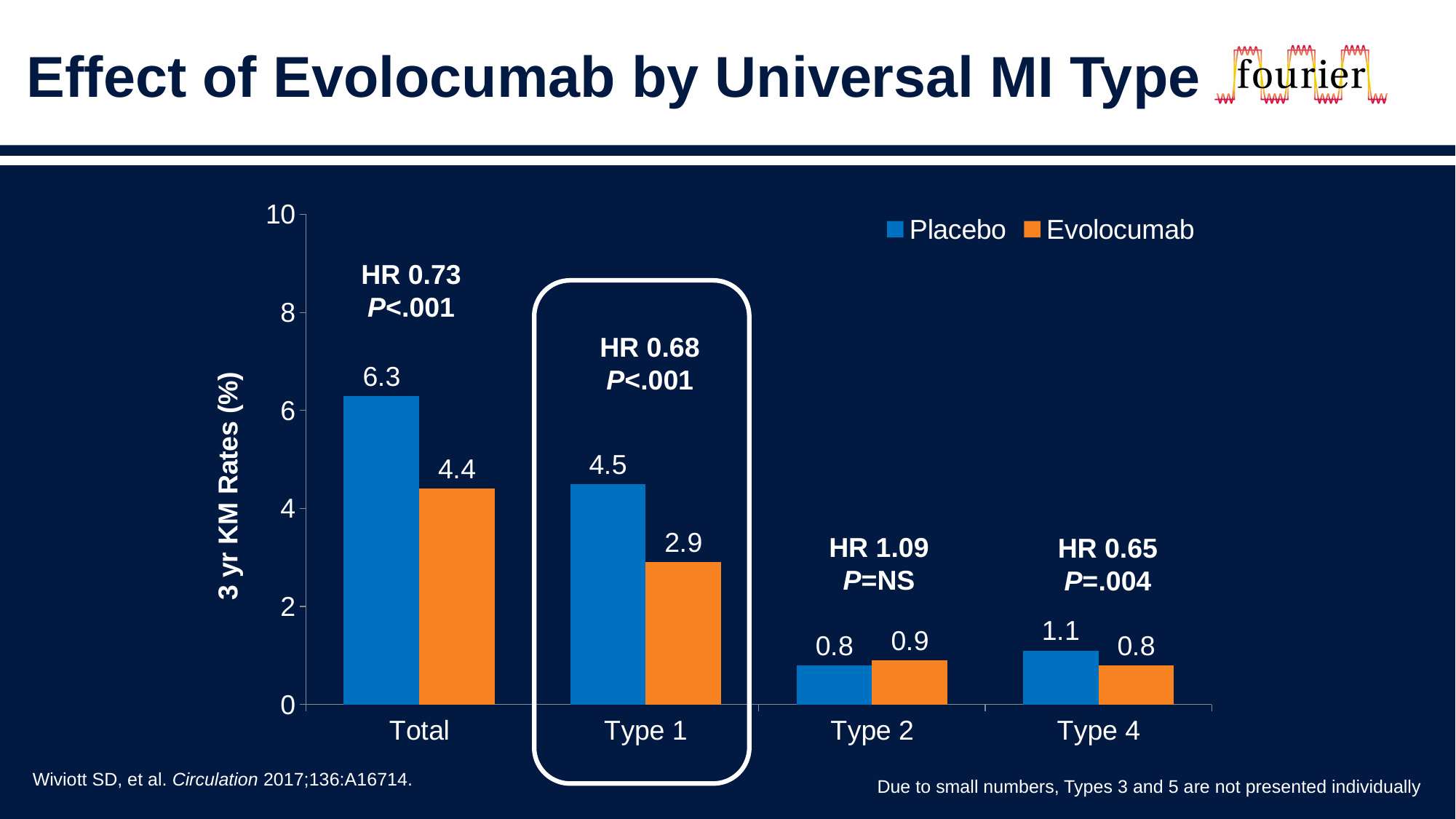
In Type 2, which is larger, the Placebo rate or the Evolocumab rate? Evolocumab What is the difference between the Placebo and Evolocumab rates in Type 1? 1.6 Which category has the lowest Evolocumab rate? Type 4 How many MI type categories are shown on the x axis? 4 How many series does the legend list? 2 What is the 3 yr KM rate for Evolocumab in Type 2? 0.9 What is the 3 yr KM rate for Placebo in the Total category? 6.3 What kind of chart is shown on the slide? Bar chart What is the 3 yr KM rate for Evolocumab in Type 1? 2.9 What is the difference between the Placebo and Evolocumab rates in the Total category? 1.9 What is the 3 yr KM rate for Placebo in Type 4? 1.1 Which category has the highest Placebo rate? Total